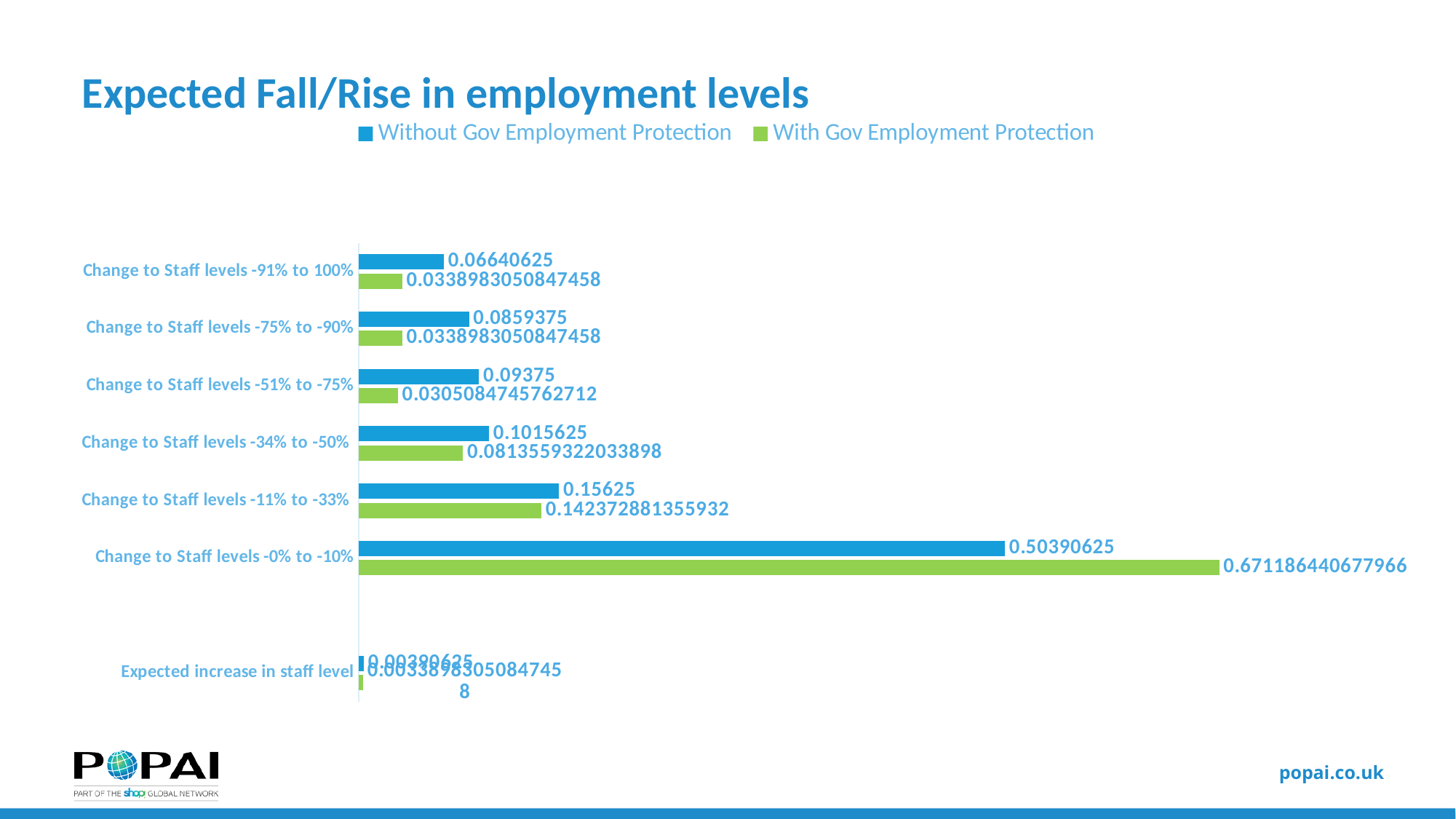
What type of chart is shown on the slide? bar chart In the category 'Change to Staff levels -0% to -10%', which series has the larger value? With Gov Employment Protection What is the value for 'Without Gov Employment Protection' in the category 'Change to Staff levels -91% to 100%'? 0.06640625 In the category 'Change to Staff levels -51% to -75%', which series has the larger value? Without Gov Employment Protection Which category has the highest value for 'With Gov Employment Protection'? Change to Staff levels -0% to -10% What is the value for 'Without Gov Employment Protection' in the category 'Change to Staff levels -0% to -10%'? 0.50390625 How many series does the legend list? 2 What is the title of the chart? Expected Fall/Rise in employment levels How many categories are shown on the chart? 7 What is the value for 'Without Gov Employment Protection' in the category 'Change to Staff levels -11% to -33%'? 0.15625 What is the value for 'With Gov Employment Protection' in the category 'Change to Staff levels -0% to -10%'? 0.671186440677966 What is the value for 'With Gov Employment Protection' in the category 'Change to Staff levels -34% to -50%'? 0.0813559322033898